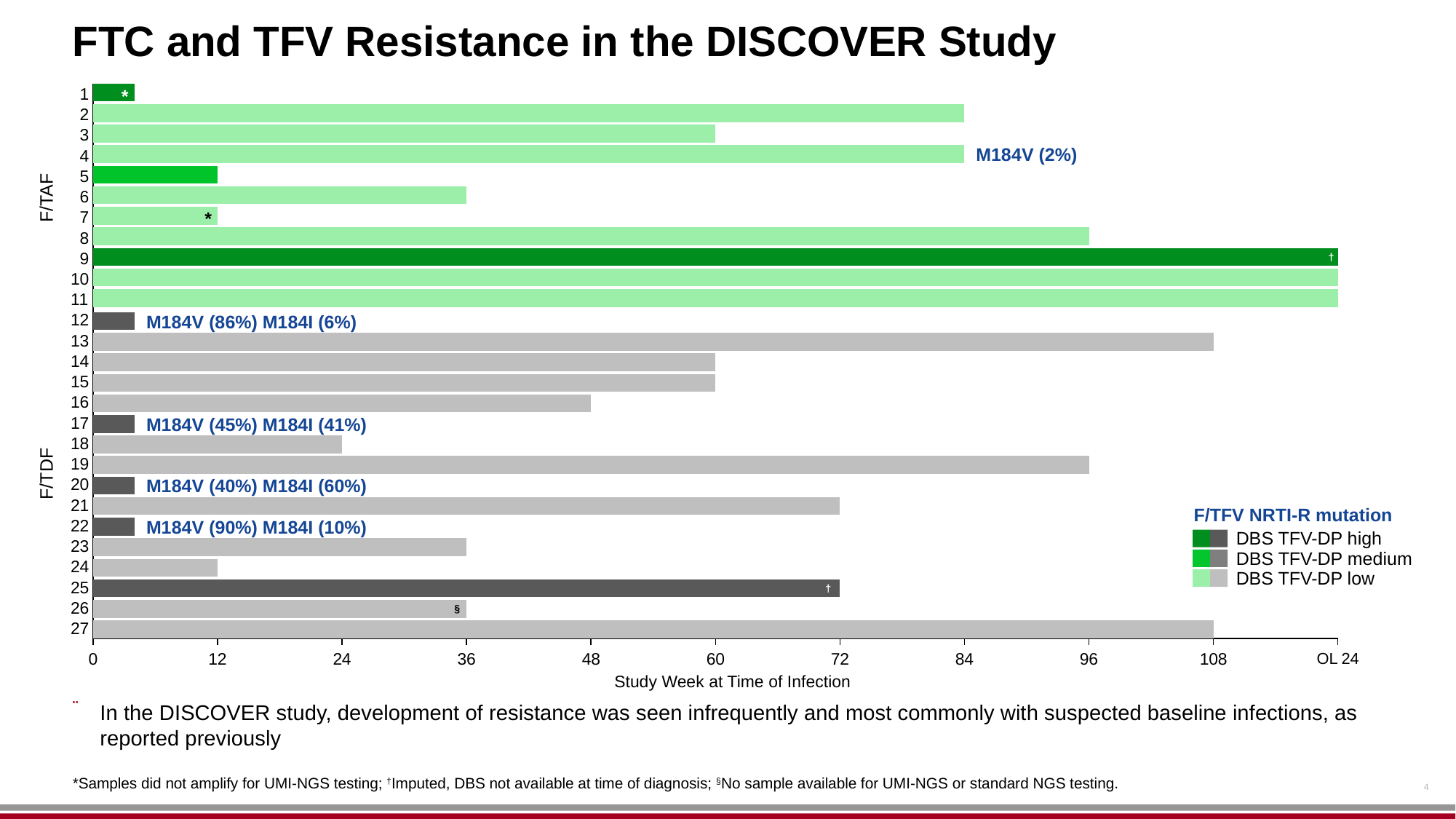
What kind of chart is shown on the slide? bar chart What is the study week at time of infection for participant 13? 108 What is the difference in study week at time of infection between participant 27 and participant 23? 72 What mutation annotation is shown next to participant 4's bar? M184V (2%) How many DBS TFV-DP levels does the legend list? 3 Which has the later study week at time of infection, participant 3 or participant 16? participant 3 What is the study week at time of infection for participant 21? 72 How many participants (bars) are plotted in the chart? 27 What is the label of the x axis? Study Week at Time of Infection Is the study week at time of infection for participant 19 greater or less than 84? greater What is the study week at time of infection for participant 8? 96 What is the study week at time of infection for participant 18? 24